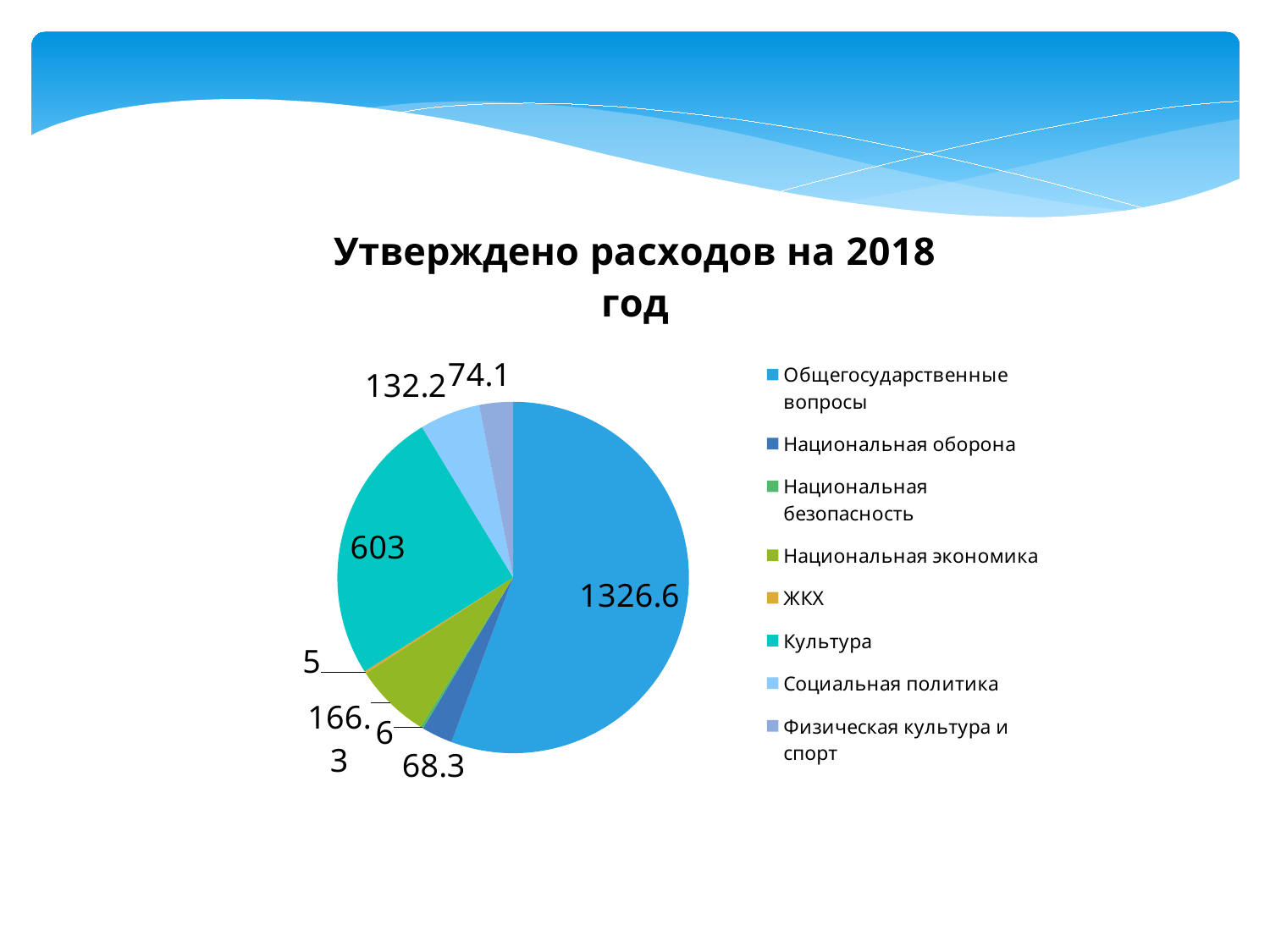
Which category has the smallest value? ЖКХ What is the value for Культура? 603 What is the title of the chart? Утверждено расходов на 2018 год What is the difference between the values for Общегосударственные вопросы and Культура? 723.6 What is the value for Физическая культура и спорт? 74.1 What is the value for Национальная оборона? 68.3 Which category has the largest slice of the pie? Общегосударственные вопросы What kind of chart is shown on the slide? pie chart How many categories does the legend list? 8 What is the value for Общегосударственные вопросы? 1326.6 Which is larger, the value for Социальная политика or the value for Физическая культура и спорт? Социальная политика What is the value for Социальная политика? 132.2